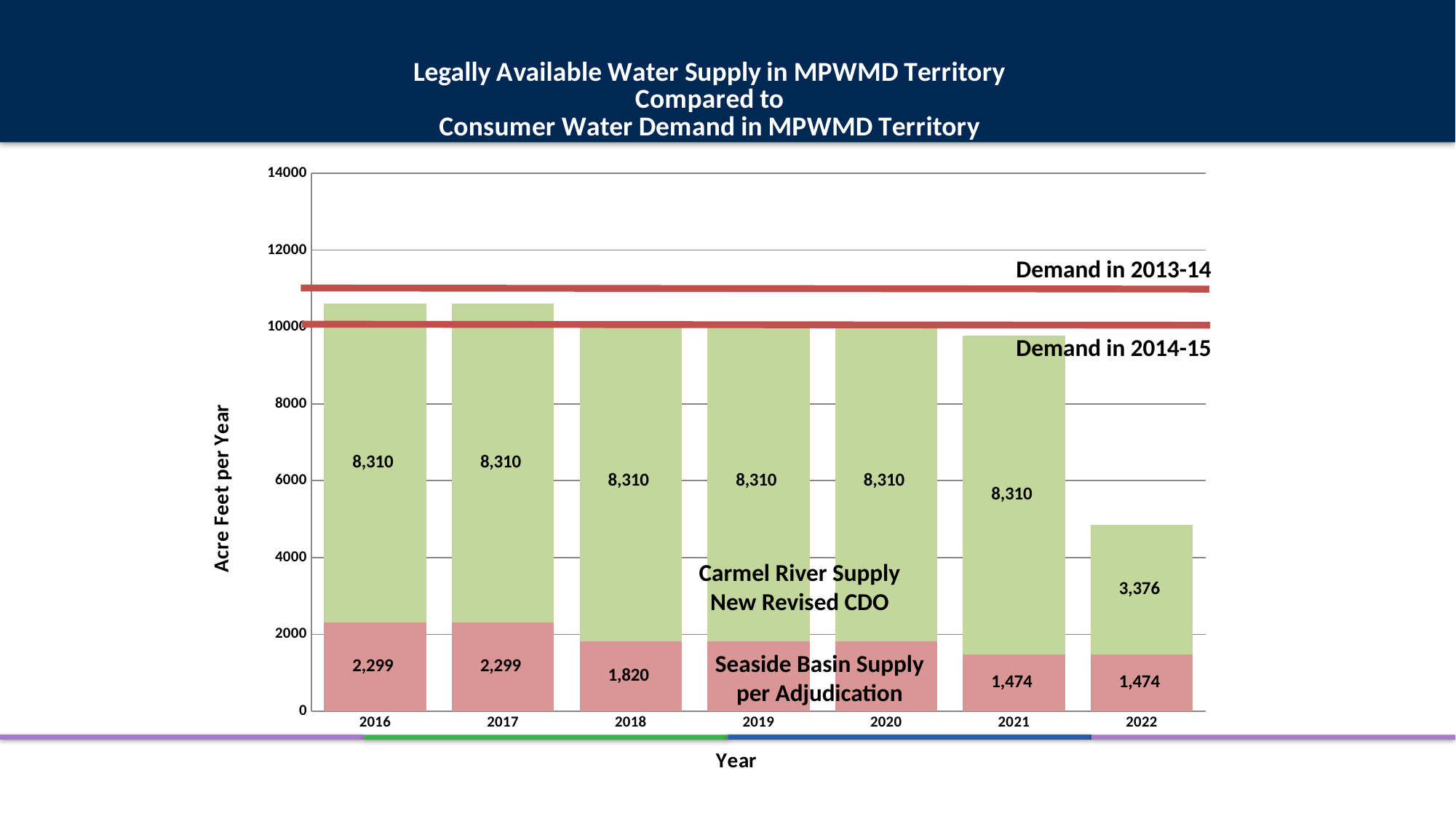
Which year has the lowest Carmel River Supply value? 2022 What kind of chart is shown on the slide? stacked bar chart What is the Carmel River Supply value for 2022? 3,376 What is the difference between the Seaside Basin Supply in 2016 and in 2022? 825 Is the Seaside Basin Supply value for 2017 larger or smaller than the value for 2020? larger What is the Seaside Basin Supply value for 2021? 1,474 What is the Carmel River Supply value for 2016? 8,310 What is the Seaside Basin Supply value for 2018? 1,820 What is the label of the y axis? Acre Feet per Year What is the total of the stacked bar for 2021? 9,784 What is the total of the stacked bar for 2022? 4,850 How many years are shown on the x axis? 7